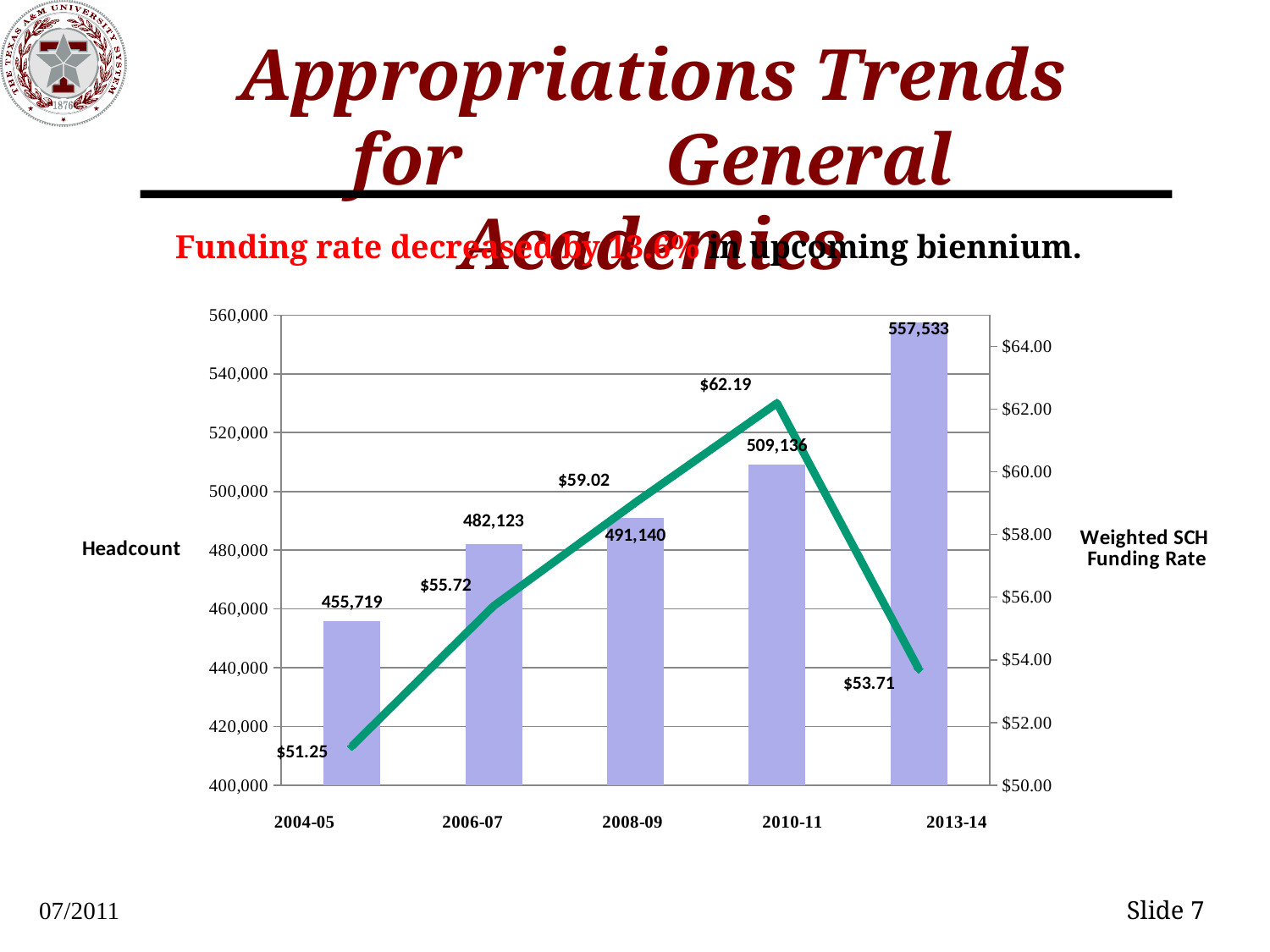
What is the Headcount value for 2013-14? 557,533 What is the Weighted SCH Funding Rate for 2013-14? $53.71 What kind of chart is shown on the slide? Combined bar and line chart Which period has the lowest Headcount? 2004-05 Which is larger, the Headcount for 2006-07 or for 2008-09? 2008-09 What is the difference in Headcount between 2013-14 and 2010-11? 48,397 Which period has the highest Weighted SCH Funding Rate? 2010-11 How many periods are shown on the x axis of the chart? 5 What is the Weighted SCH Funding Rate for 2010-11? $62.19 What is the Headcount value for 2004-05? 455,719 Does the Headcount rise or fall from 2004-05 to 2013-14? rise What is the difference in Weighted SCH Funding Rate between 2010-11 and 2013-14? $8.48